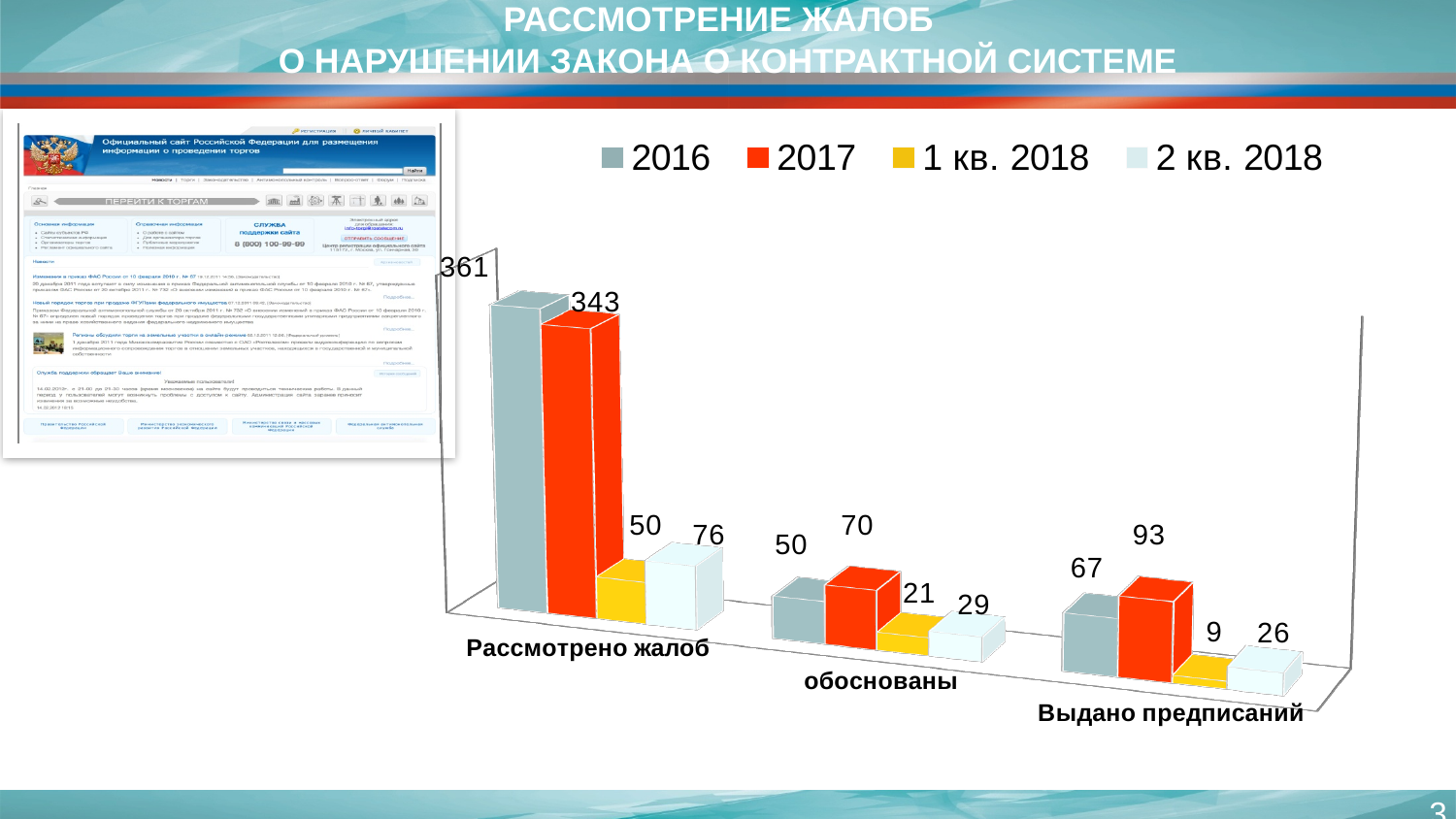
What is the difference between the 2016 and 2017 values in the "Рассмотрено жалоб" category? 18 Which series has the lowest value in the "обоснованы" category? 1 кв. 2018 Which is larger in the "Выдано предписаний" category: the value for 2016 or for 2017? 2017 What kind of chart is shown on the slide? bar chart What is the value for 2016 in the "Рассмотрено жалоб" category? 361 What is the value for 2 кв. 2018 in the "Рассмотрено жалоб" category? 76 What colour represents the 2017 series in the chart? red Which series has the highest value in the "Выдано предписаний" category? 2017 What is the value for 1 кв. 2018 in the "Выдано предписаний" category? 9 How many series does the chart legend list? 4 What is the value for 2017 in the "обоснованы" category? 70 How many categories are shown on the x axis of the chart? 3